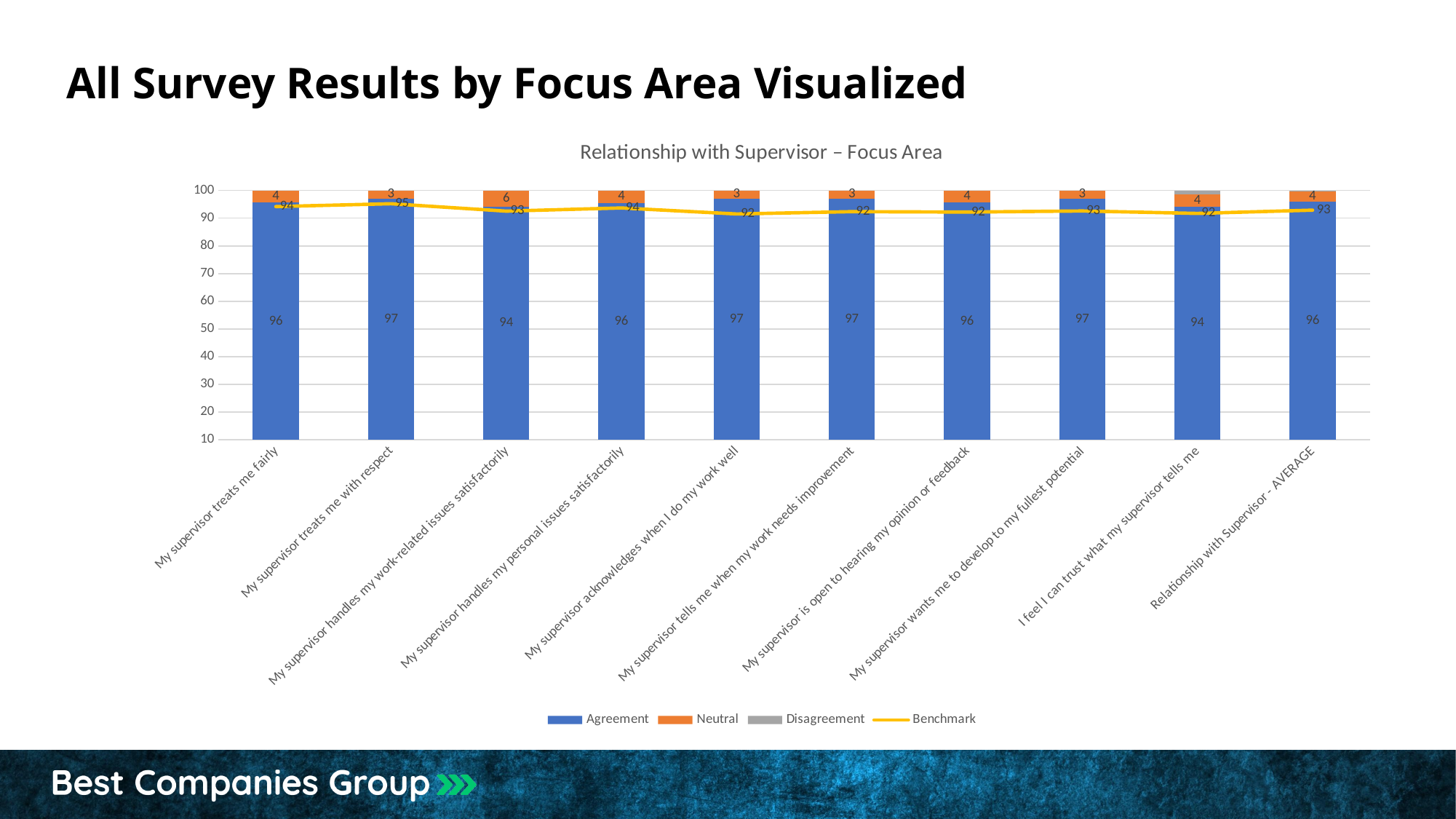
What is the Neutral value for "My supervisor handles my work-related issues satisfactorily"? 6 Which category has the highest Neutral value? My supervisor handles my work-related issues satisfactorily What is the difference between the Agreement value and the Benchmark value for "My supervisor acknowledges when I do my work well"? 5 What is the Agreement value for "Relationship with Supervisor - AVERAGE"? 96 What is the title of the chart? Relationship with Supervisor – Focus Area How many categories are shown on the x axis? 10 What is the Agreement value for "My supervisor treats me with respect"? 97 Which is larger, the Agreement value for "My supervisor treats me fairly" or for "My supervisor handles my work-related issues satisfactorily"? My supervisor treats me fairly What kind of chart is this? Stacked bar chart with a line Which category has the highest Benchmark value? My supervisor treats me with respect How many series does the legend list? 4 What is the Benchmark value for "My supervisor treats me fairly"? 94